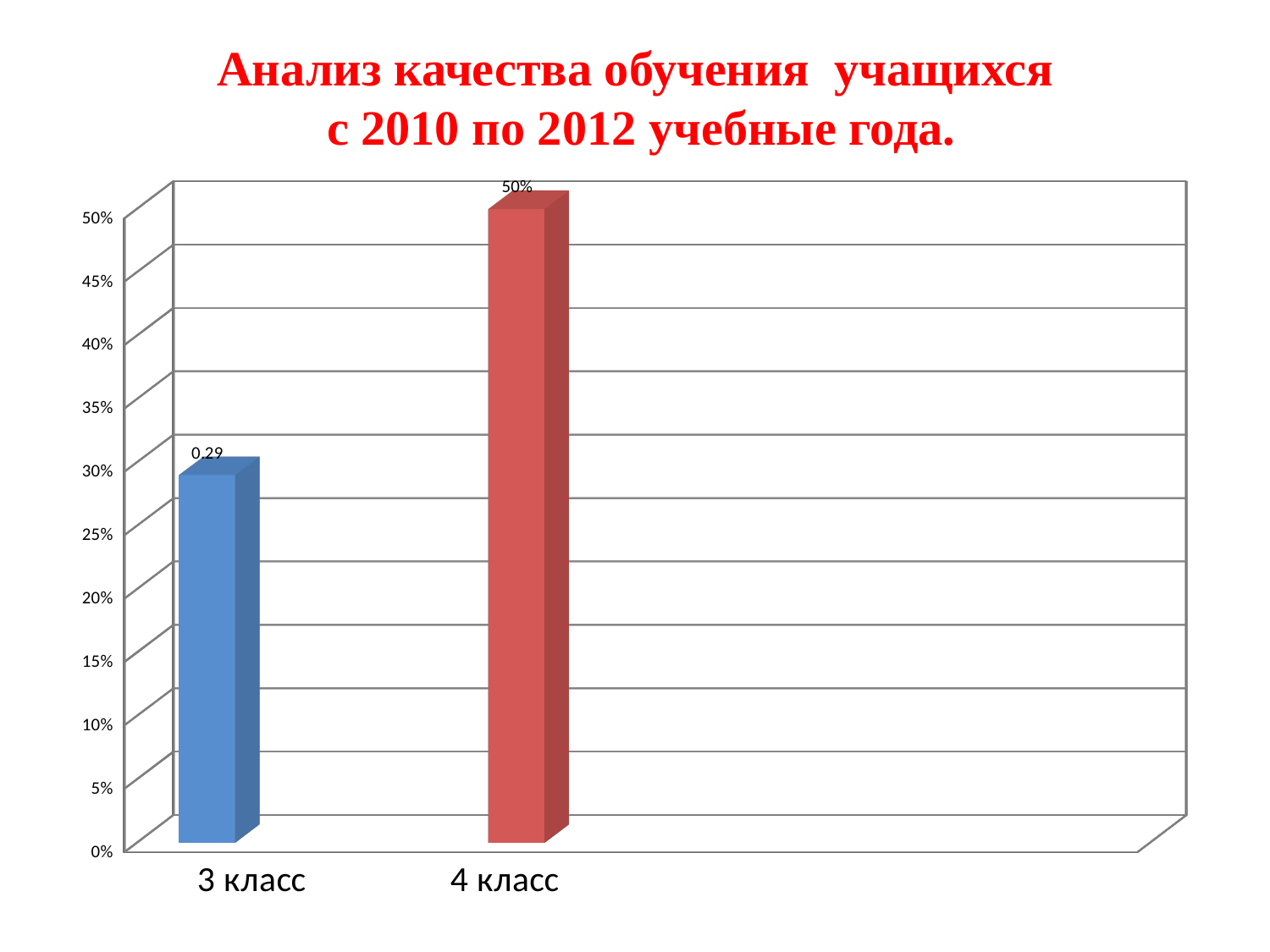
What kind of chart is shown on the slide? bar chart Is the value for 4 класс greater or less than 40%? greater What value is shown for 3 класс? 0,29 Do the values rise or fall from 3 класс to 4 класс? rise What colour is the bar for 4 класс? red What value is shown for 4 класс? 50% Which is larger, the value for 3 класс or the value for 4 класс? 4 класс Which category has the lowest value? 3 класс Is the value for 3 класс greater or less than 25%? greater Which category has the highest value? 4 класс How many categories are shown on the x axis? 2 What is the title of the slide? Анализ качества обучения учащихся с 2010 по 2012 учебные года.